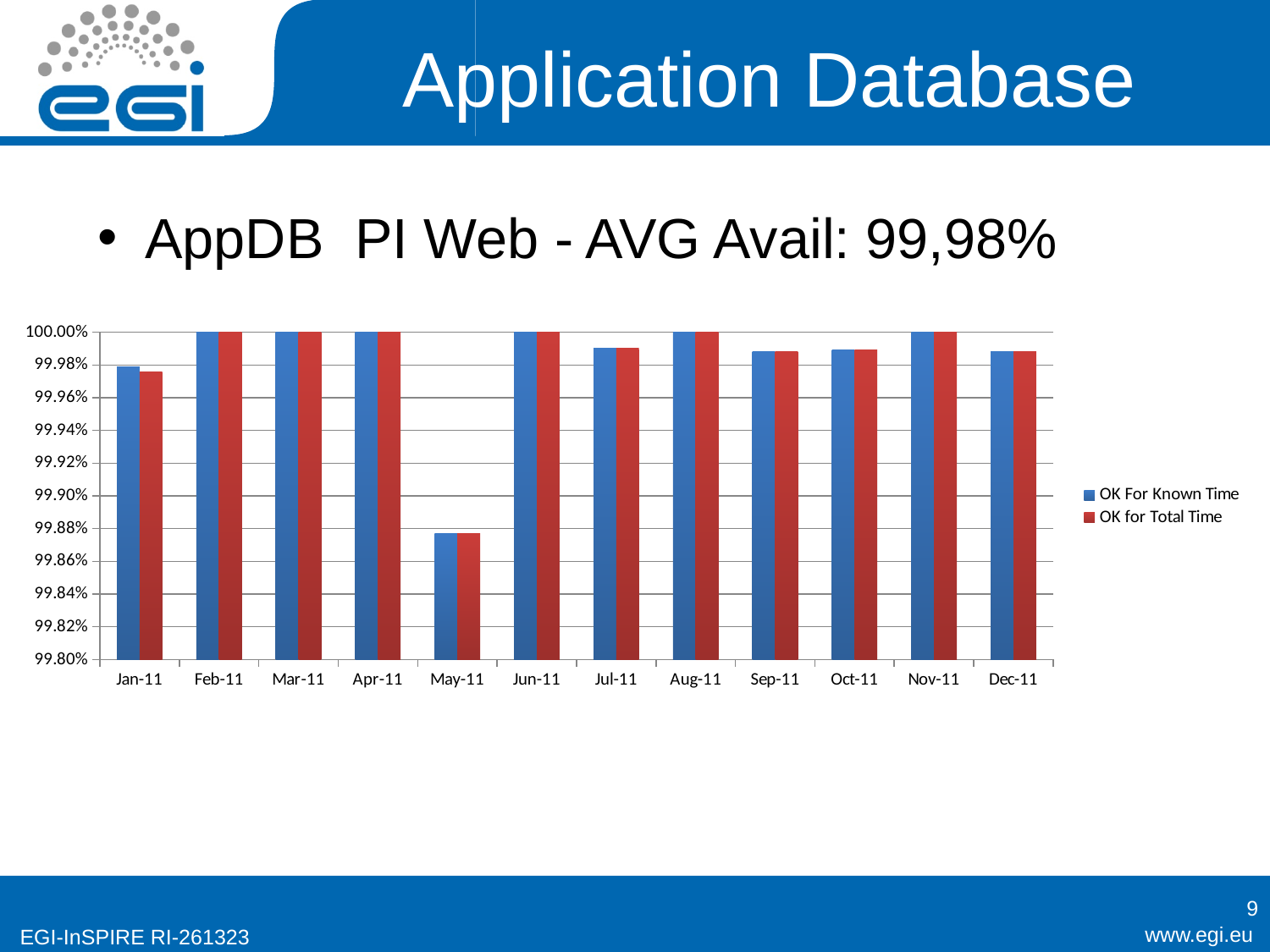
Is the 'OK For Known Time' value for May-11 greater or less than 99.90%? less How many months are shown on the x axis of the chart? 12 What is the 'OK for Total Time' value for Aug-11? 100.00% Is the 'OK for Total Time' value for Jan-11 greater or less than 99.96%? greater What kind of chart is shown on the slide? bar chart What is the 'OK For Known Time' value for Feb-11? 100.00% Which month has the larger 'OK for Total Time' value, Jan-11 or Jul-11? Jul-11 What are the two legend entries of the chart? OK For Known Time; OK for Total Time Which month has the lowest availability values in the chart? May-11 How many series does the chart legend list? 2 Is the 'OK For Known Time' value for Jul-11 greater or less than 99.98%? greater Which month has the larger 'OK For Known Time' value, Jan-11 or May-11? Jan-11